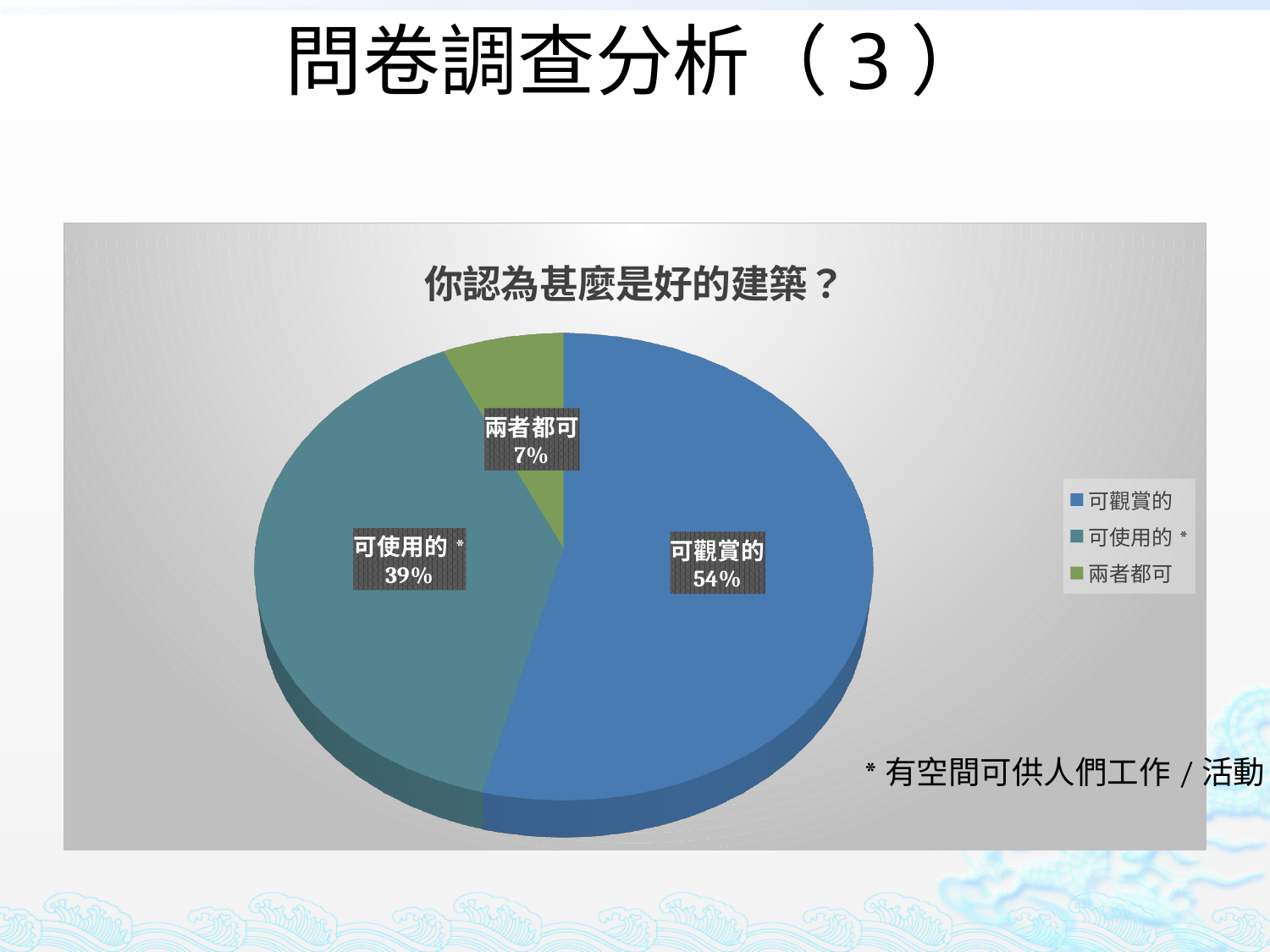
Which is larger, the share for 可使用的 or the share for 兩者都可? 可使用的 How many entries does the legend list? 3 Which category has the largest share of the pie? 可觀賞的 How many categories are shown in the pie chart? 3 What colour is the slice for 兩者都可? Green Which category has the smallest share of the pie? 兩者都可 What percentage of respondents chose 兩者都可? 7% What percentage of respondents chose 可使用的? 39% What kind of chart is shown on the slide? Pie chart What percentage of respondents chose 可觀賞的? 54% What is the difference in percentage points between 可觀賞的 and 可使用的? 15 What is the title of the chart? 你認為甚麼是好的建築？